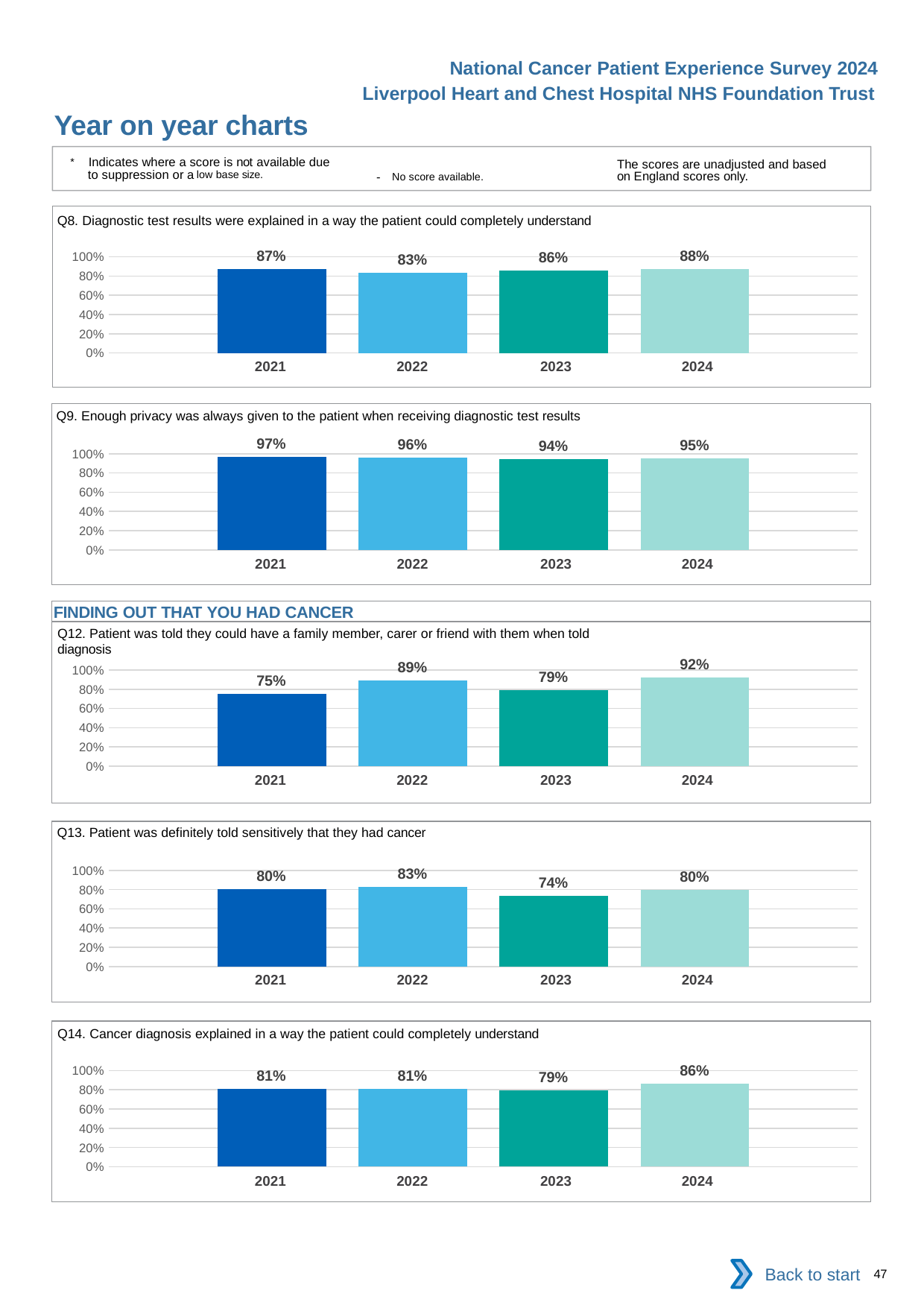
In the Q9 chart (Enough privacy was always given to the patient when receiving diagnostic test results), what is the difference between the 2021 and 2024 values? 2 percentage points In the Q9 chart (Enough privacy was always given to the patient when receiving diagnostic test results), which year has the lowest value? 2023 In the Q12 chart (Patient was told they could have a family member, carer or friend with them when told diagnosis), which is larger, the 2022 value or the 2023 value? 2022 In the Q14 chart (Cancer diagnosis explained in a way the patient could completely understand), how many years are plotted? 4 In the Q8 chart (Diagnostic test results were explained in a way the patient could completely understand), what is the value for 2022? 83% In the Q14 chart (Cancer diagnosis explained in a way the patient could completely understand), which year has the highest value? 2024 In the Q8 chart (Diagnostic test results were explained in a way the patient could completely understand), which year has the highest value? 2024 In the Q12 chart (Patient was told they could have a family member, carer or friend with them when told diagnosis), what is the value for 2021? 75% How many charts are shown on the slide? 5 In the Q13 chart (Patient was definitely told sensitively that they had cancer), what is the difference between the 2022 and 2023 values? 9 percentage points In the Q13 chart (Patient was definitely told sensitively that they had cancer), what is the value for 2023? 74% What kind of chart is the Q8 chart (Diagnostic test results were explained in a way the patient could completely understand)? Bar chart